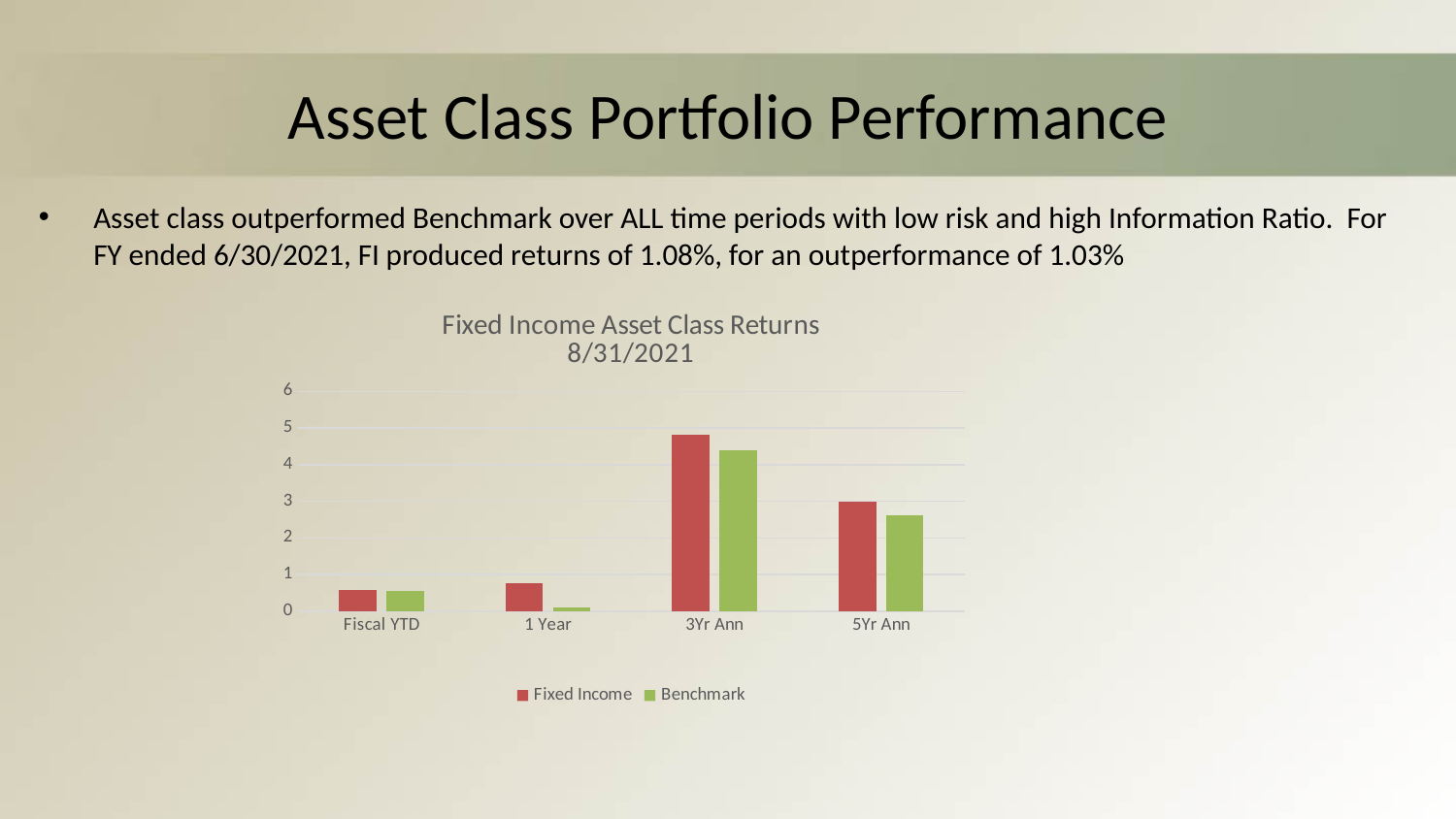
Which time period has the highest Fixed Income return in the chart? 3Yr Ann Is the Benchmark value for 5Yr Ann greater or less than 2? greater For the 5Yr Ann period, which is larger: Fixed Income or Benchmark? Fixed Income Is the Benchmark value for 1 Year greater or less than 1? less How many series does the chart legend list? 2 Which time period has the lowest Benchmark return in the chart? 1 Year What is the title of the chart? Fixed Income Asset Class Returns 8/31/2021 How many time-period categories are shown on the x axis of the chart? 4 What kind of chart is shown on the slide? bar chart For the 1 Year period, which is larger: Fixed Income or Benchmark? Fixed Income Is the Fixed Income value for 3Yr Ann greater or less than 4? greater Which series is shown in green in the chart? Benchmark